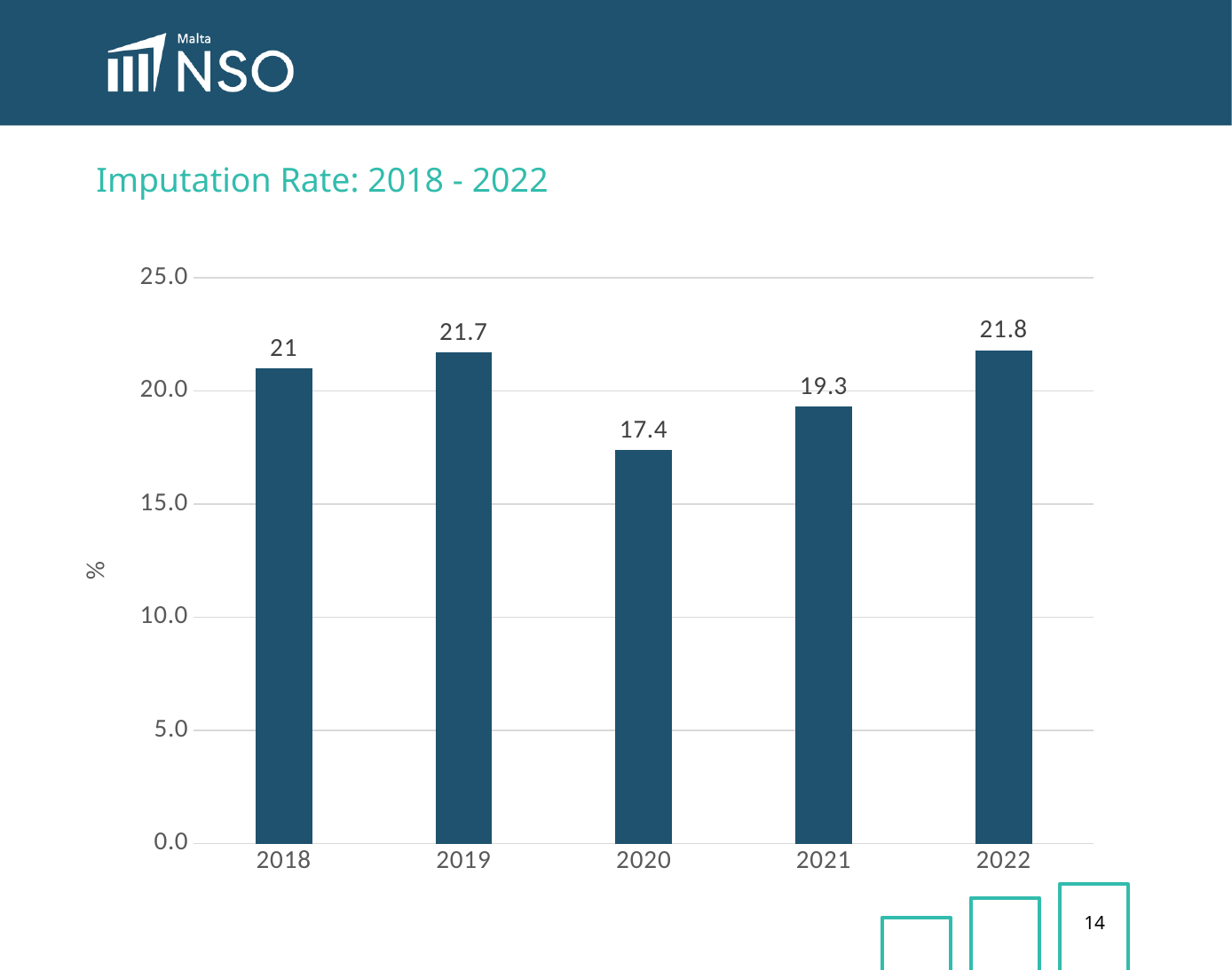
What is the difference between the imputation rate in 2019 and in 2021? 2.4 What is the imputation rate for 2018? 21 What is the difference between the imputation rate in 2022 and in 2020? 4.4 Which year has a higher imputation rate, 2018 or 2021? 2018 How many years are shown on the chart? 5 Which year has the lowest imputation rate? 2020 What kind of chart is shown on the slide? bar chart What is the title of the chart? Imputation Rate: 2018 - 2022 Is the imputation rate for 2020 greater or less than 20.0? less What is the imputation rate for 2020? 17.4 What is the imputation rate for 2021? 19.3 Which year has the highest imputation rate? 2022